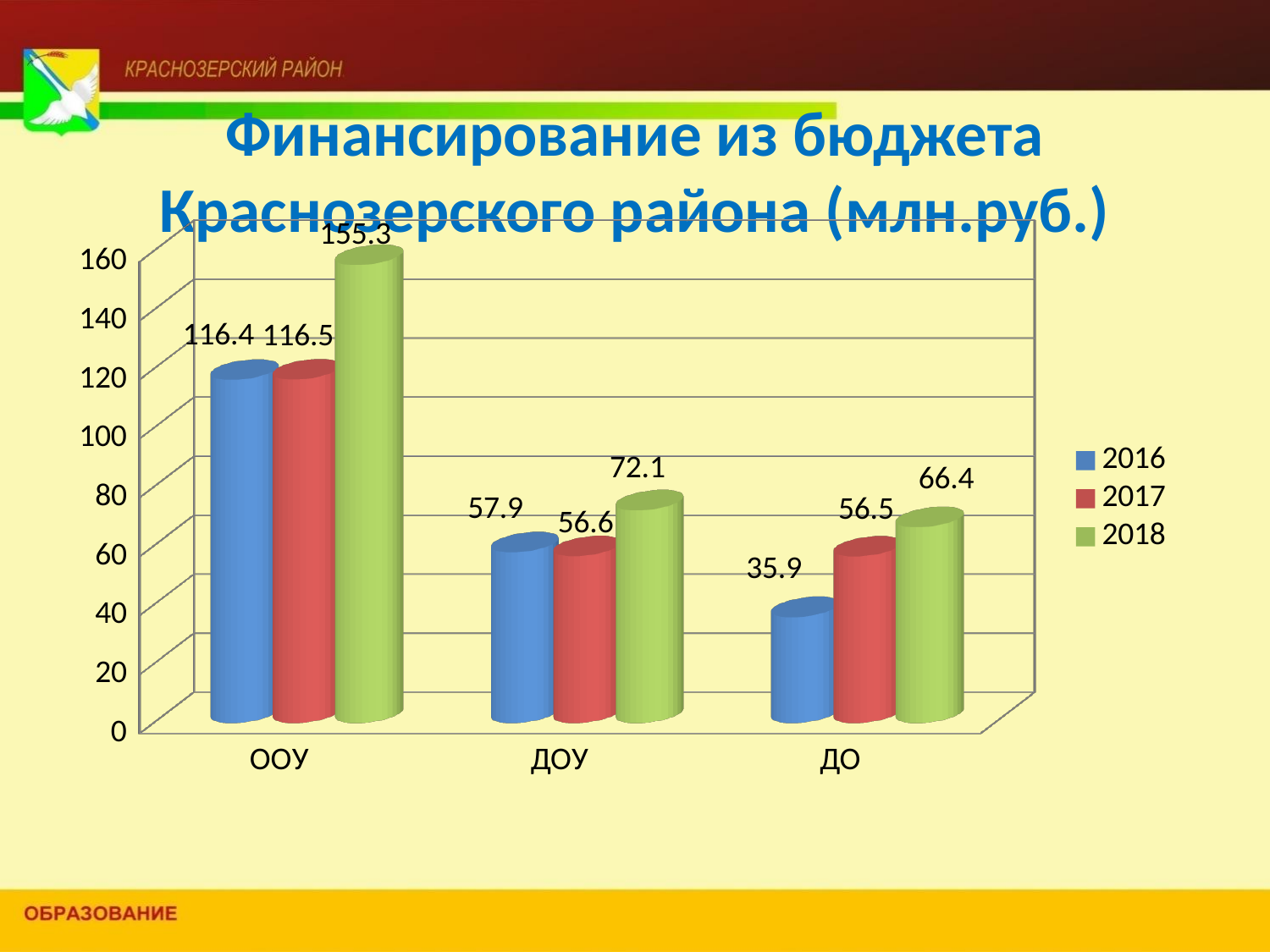
How many series does the legend list? 3 What kind of chart is shown on the slide? bar chart What is the difference between the 2017 and 2016 values for ДО? 20.6 Which category has the highest value in 2018? ООУ Which category has the lowest value in 2016? ДО How many categories are shown on the x axis? 3 What is the difference between the 2018 and 2017 values for ООУ? 38.8 What is the value for ООУ in 2018? 155.3 What is the value for ДОУ in 2017? 56.6 Do the values for ДО rise or fall from 2016 to 2018? rise What is the value for ДО in 2016? 35.9 Which is larger for ДОУ: the 2016 value or the 2018 value? 2018